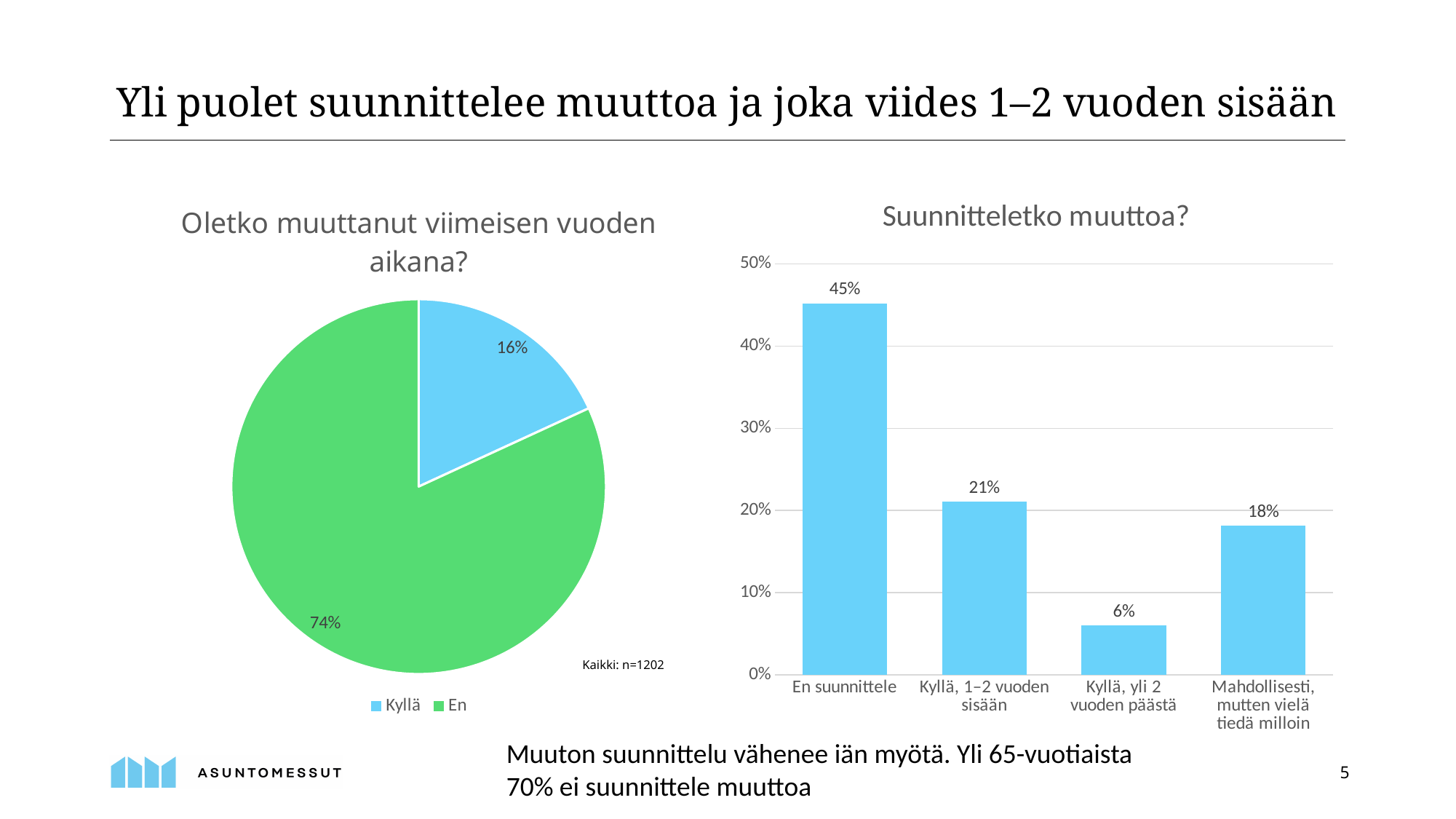
In the chart 'Suunnitteletko muuttoa?', what is the value for 'Kyllä, 1–2 vuoden sisään'? 21% In the chart 'Suunnitteletko muuttoa?', what is the difference between 'En suunnittele' and 'Mahdollisesti, mutten vielä tiedä milloin'? 27% In the pie chart 'Oletko muuttanut viimeisen vuoden aikana?', which slice is larger, 'Kyllä' or 'En'? En How many categories are shown in the chart 'Suunnitteletko muuttoa?'? 4 In the chart 'Suunnitteletko muuttoa?', is the value for 'Kyllä, yli 2 vuoden päästä' greater or less than 10%? less In the pie chart 'Oletko muuttanut viimeisen vuoden aikana?', what share is labelled for 'Kyllä'? 16% How many entries does the legend of the pie chart 'Oletko muuttanut viimeisen vuoden aikana?' list? 2 What kind of chart is 'Suunnitteletko muuttoa?'? Bar chart In the chart 'Suunnitteletko muuttoa?', which category has the lowest value? Kyllä, yli 2 vuoden päästä In the chart 'Suunnitteletko muuttoa?', what is the value for 'En suunnittele'? 45% In the chart 'Suunnitteletko muuttoa?', which category has the highest value? En suunnittele In the pie chart 'Oletko muuttanut viimeisen vuoden aikana?', what share is labelled for 'En'? 74%